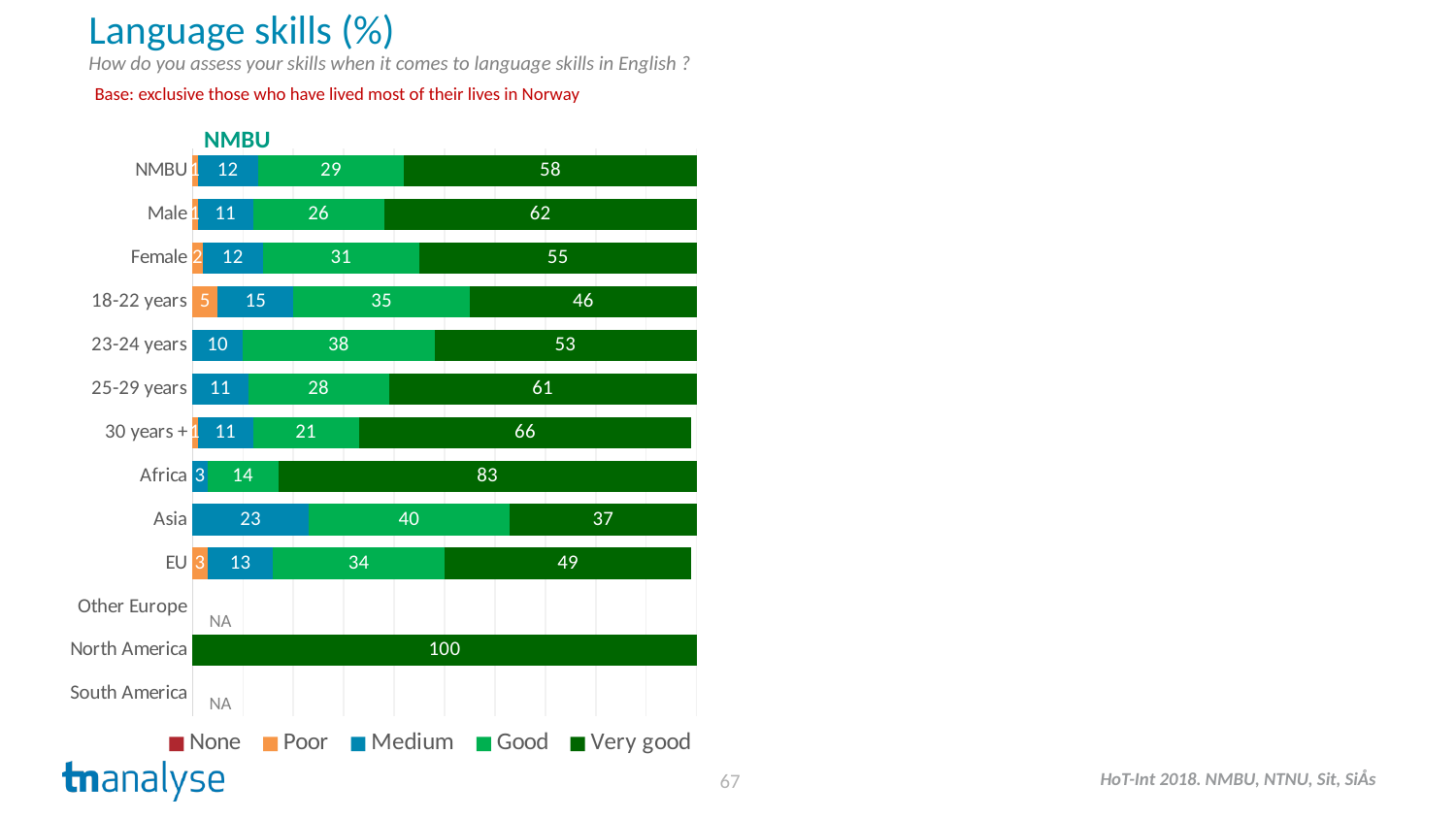
What is the 'Medium' value for 18-22 years? 15 Which category has the highest 'Very good' value? North America How many series does the legend list? 5 How many categories are listed on the vertical axis? 13 What is the 'Very good' value for Africa? 83 What is the difference between the 'Very good' values for Male and Female? 7 What is the 'Poor' value for 18-22 years? 5 What is the 'Good' value for Asia? 40 What kind of chart is shown on the slide? Stacked bar chart Which has a larger 'Good' value, 23-24 years or 25-29 years? 23-24 years What is the total of the stacked bar for Asia? 100 Among the categories with plotted values, which has the lowest 'Very good' value? Asia